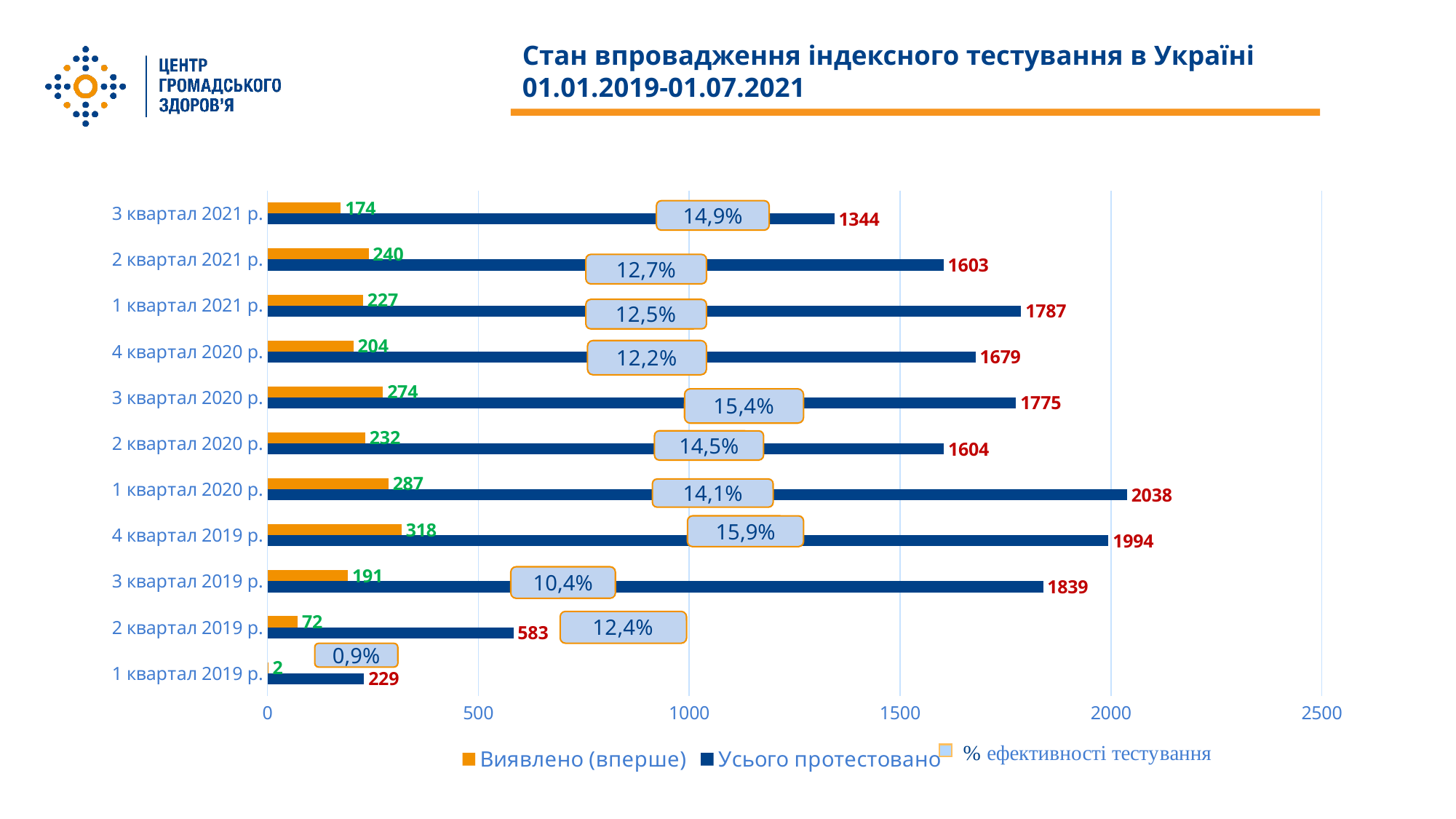
Which quarter has the highest value of 'Усього протестовано'? 1 квартал 2020 р. Which quarter has the lowest value of 'Виявлено (вперше)'? 1 квартал 2019 р. What is the value of 'Усього протестовано' for 1 квартал 2020 р.? 2038 How many series does the legend list? 3 What is the '% ефективності тестування' for 3 квартал 2021 р.? 14,9% Which is larger: 'Виявлено (вперше)' for 3 квартал 2020 р. or for 2 квартал 2020 р.? 3 квартал 2020 р. Which quarter has the highest '% ефективності тестування'? 4 квартал 2019 р. What is the difference in 'Усього протестовано' between 1 квартал 2021 р. and 2 квартал 2021 р.? 184 How many quarters (categories) are shown on the chart? 11 What is the value of 'Виявлено (вперше)' for 4 квартал 2019 р.? 318 What type of chart is shown on the slide? Bar chart What is the title of the chart on the slide? Стан впровадження індексного тестування в Україні 01.01.2019-01.07.2021